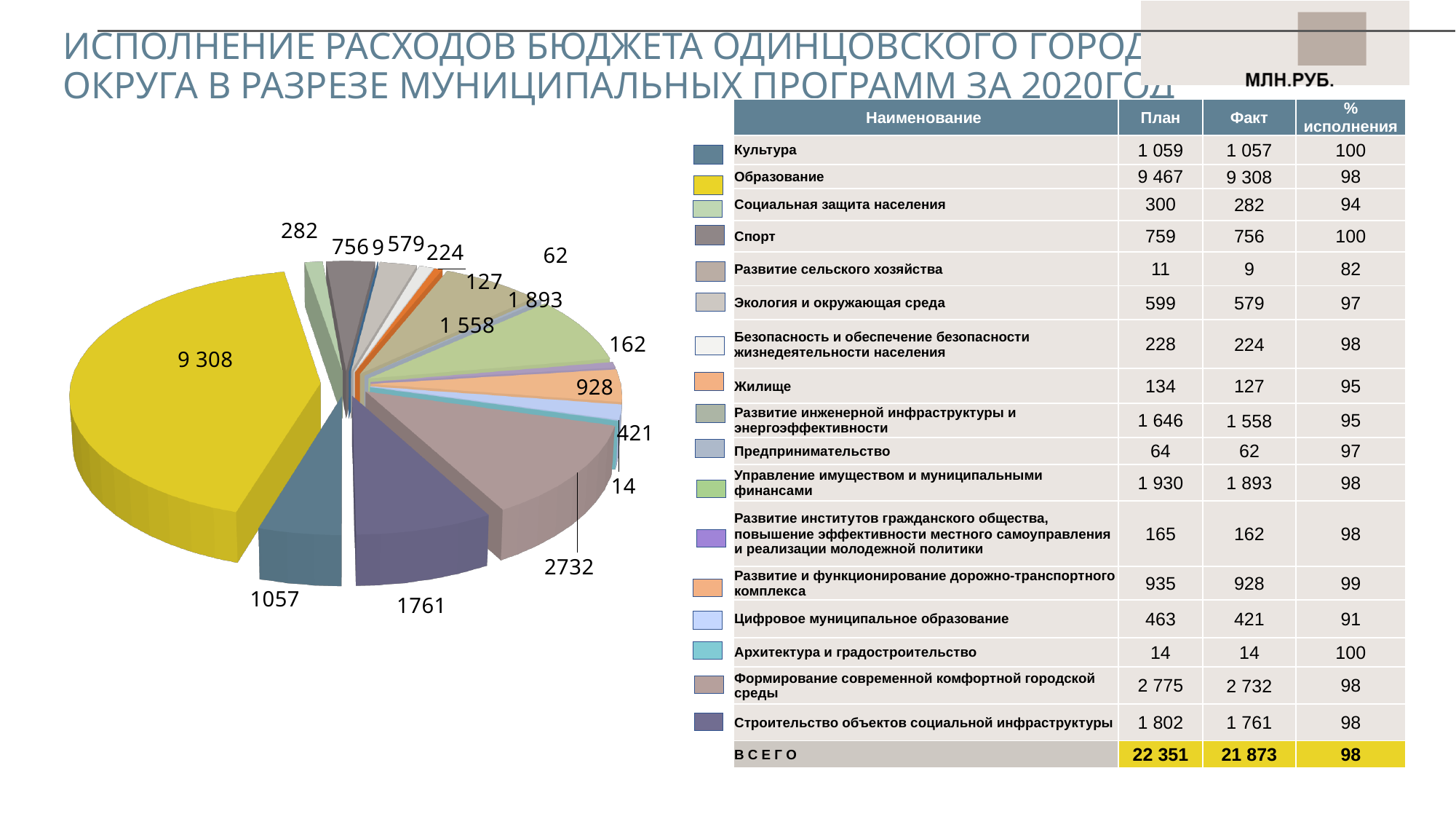
Which slice of the pie chart has the smallest value? Развитие сельского хозяйства (9) What is the difference between the slice labelled 928 and the slice labelled 421? 507 Which is larger in the pie chart: the slice for Управление имуществом и муниципальными финансами (1 893) or the slice for Развитие инженерной инфраструктуры и энергоэффективности (1 558)? Управление имуществом и муниципальными финансами (1 893) What value is labelled on the slice for Строительство объектов социальной инфраструктуры? 1761 What value is labelled on the slice for Формирование современной комфортной городской среды? 2732 What is the difference between the slice labelled 2732 and the slice labelled 1761? 971 In what units are the values on the slide expressed? МЛН.РУБ. What value is labelled on the yellow slice of the pie chart? 9 308 Which slice of the pie chart has the largest value? Образование (9 308) What value is labelled on the slice for Культура in the pie chart? 1057 What kind of chart is shown on the left of the slide? pie chart